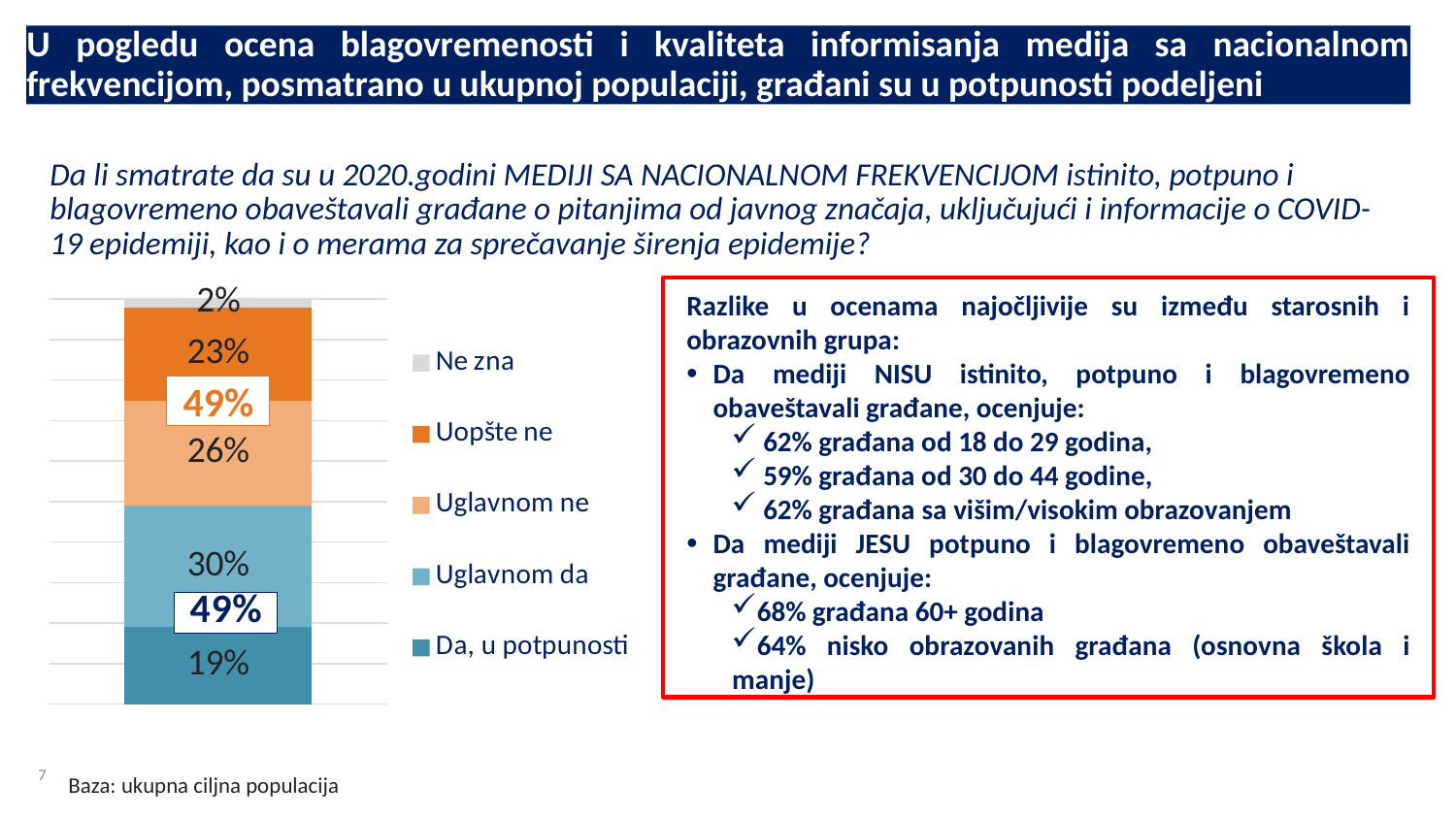
What type of chart is shown on the slide? Stacked bar chart What percentage of respondents answered "Uglavnom da"? 30% Which is larger, the share for "Uglavnom ne" or the share for "Uopšte ne"? Uglavnom ne What percentage of respondents answered "Da, u potpunosti"? 19% What is the difference between the "Uglavnom da" share and the "Da, u potpunosti" share? 11% Which legend entry is shown in the darkest blue colour? Da, u potpunosti Which response category has the largest share in the stacked bar? Uglavnom da What is the combined share of "Uopšte ne" and "Uglavnom ne" as labelled on the chart? 49% What percentage of respondents answered "Uopšte ne"? 23% How many response categories does the legend list? 5 What percentage of respondents answered "Ne zna"? 2% Which response category has the smallest share in the stacked bar? Ne zna